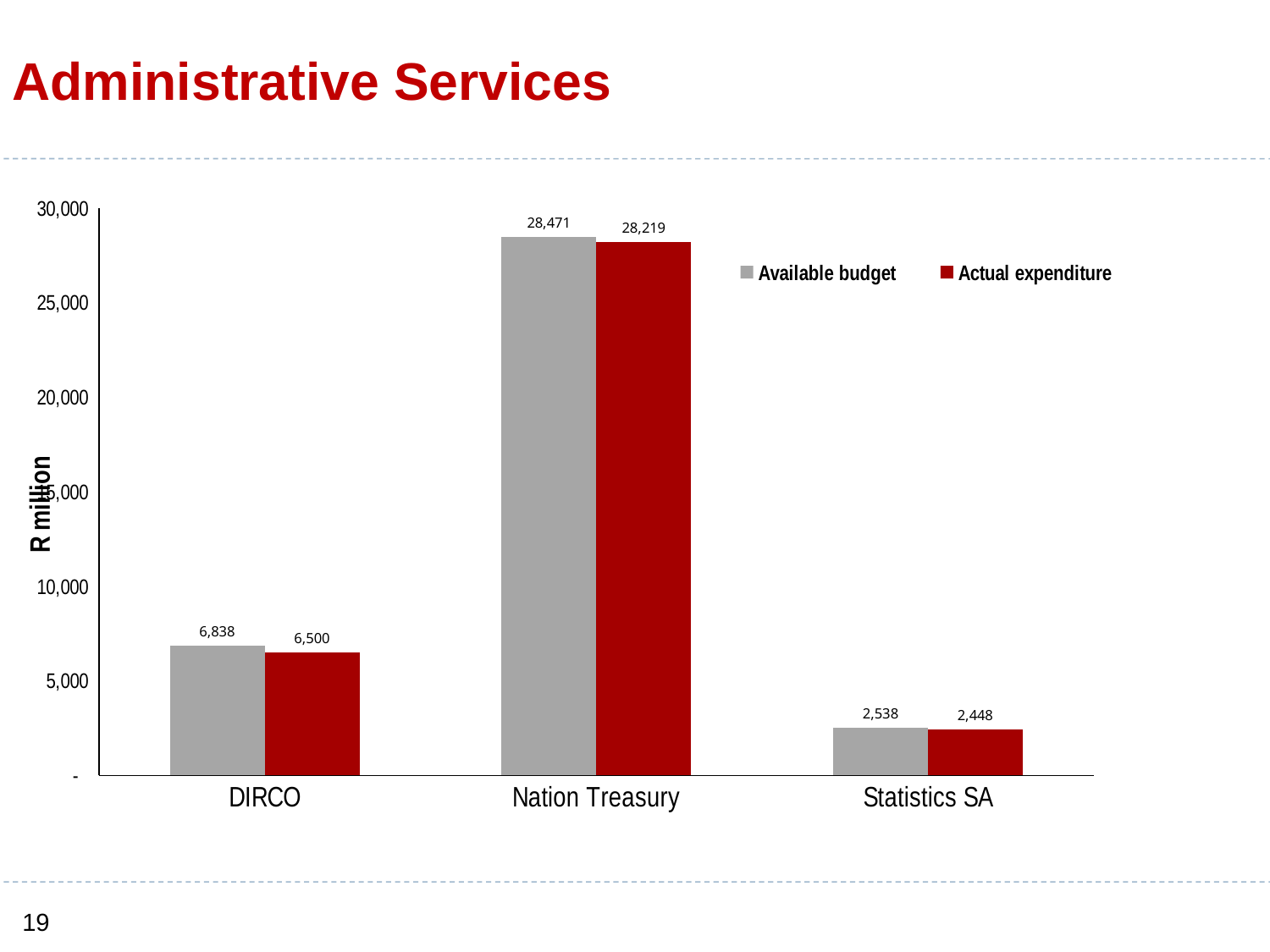
What is the Actual expenditure for Nation Treasury? 28,219 Is the Available budget for DIRCO greater or less than 5,000? greater How many categories are shown on the x axis? 3 Which category has the lowest Actual expenditure? Statistics SA How many series does the legend list? 2 What kind of chart is shown on the slide? Bar chart What is the Available budget for DIRCO? 6,838 What is the Actual expenditure for Statistics SA? 2,448 What is the difference between the Available budget and Actual expenditure for Nation Treasury? 252 Which category has the highest Available budget? Nation Treasury What is the difference between the Available budget and Actual expenditure for DIRCO? 338 Which is larger for Statistics SA, the Available budget or the Actual expenditure? Available budget